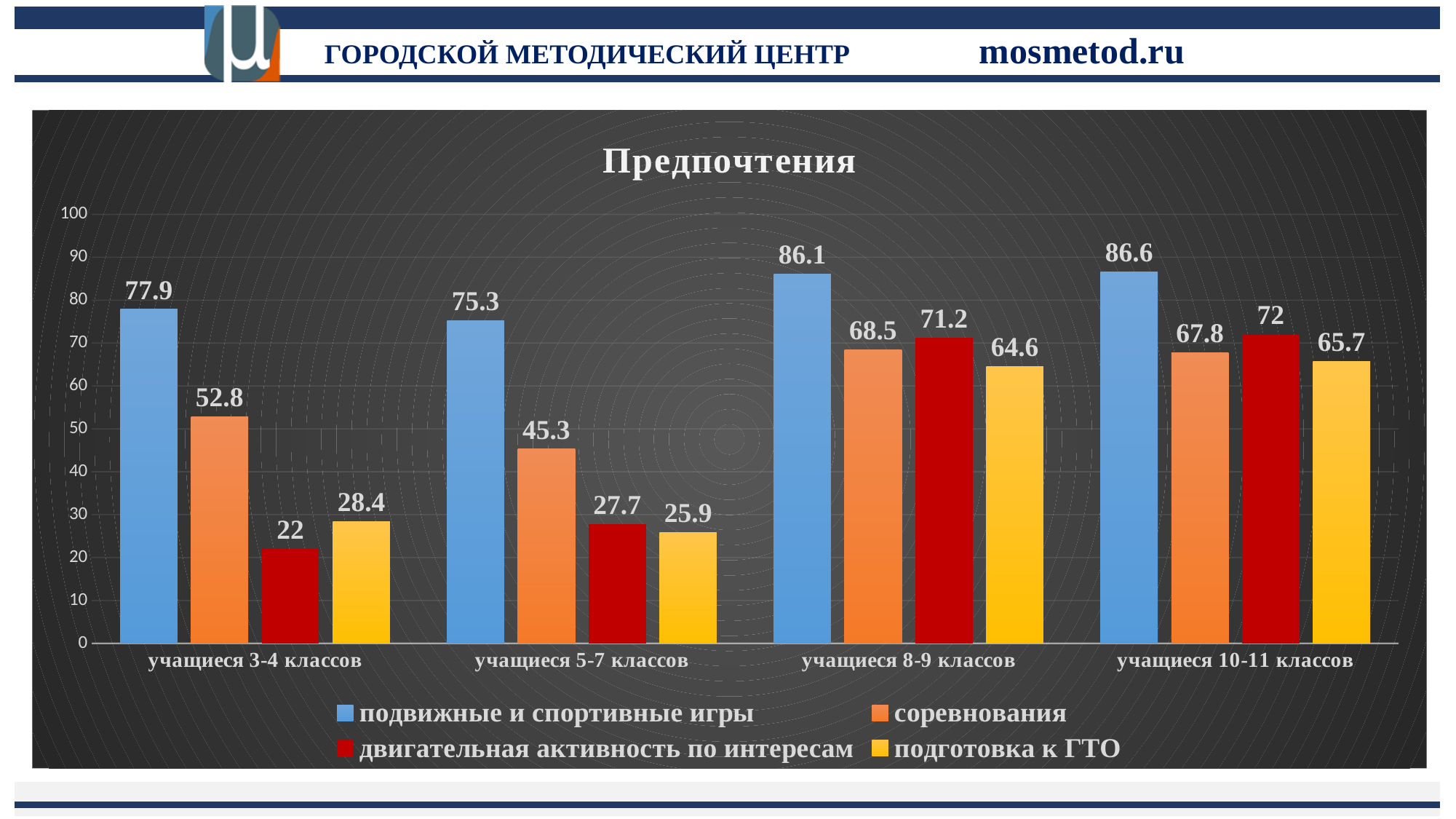
Which category has the lowest value for "двигательная активность по интересам"? учащиеся 3-4 классов What is the value for "подготовка к ГТО" among "учащиеся 8-9 классов"? 64.6 What is the value for "двигательная активность по интересам" among "учащиеся 10-11 классов"? 72 What is the difference between the "подвижные и спортивные игры" value and the "соревнования" value for "учащиеся 3-4 классов"? 25.1 What type of chart is shown on the slide? bar chart Is the value for "подготовка к ГТО" among "учащиеся 5-7 классов" greater or less than 30? less What is the value for "соревнования" among "учащиеся 5-7 классов"? 45.3 What is the value for "подвижные и спортивные игры" among "учащиеся 3-4 классов"? 77.9 How many categories are shown on the x axis? 4 How many series does the legend list? 4 Which category has the highest value for "подвижные и спортивные игры"? учащиеся 10-11 классов For "учащиеся 8-9 классов", which is larger: "соревнования" or "двигательная активность по интересам"? двигательная активность по интересам